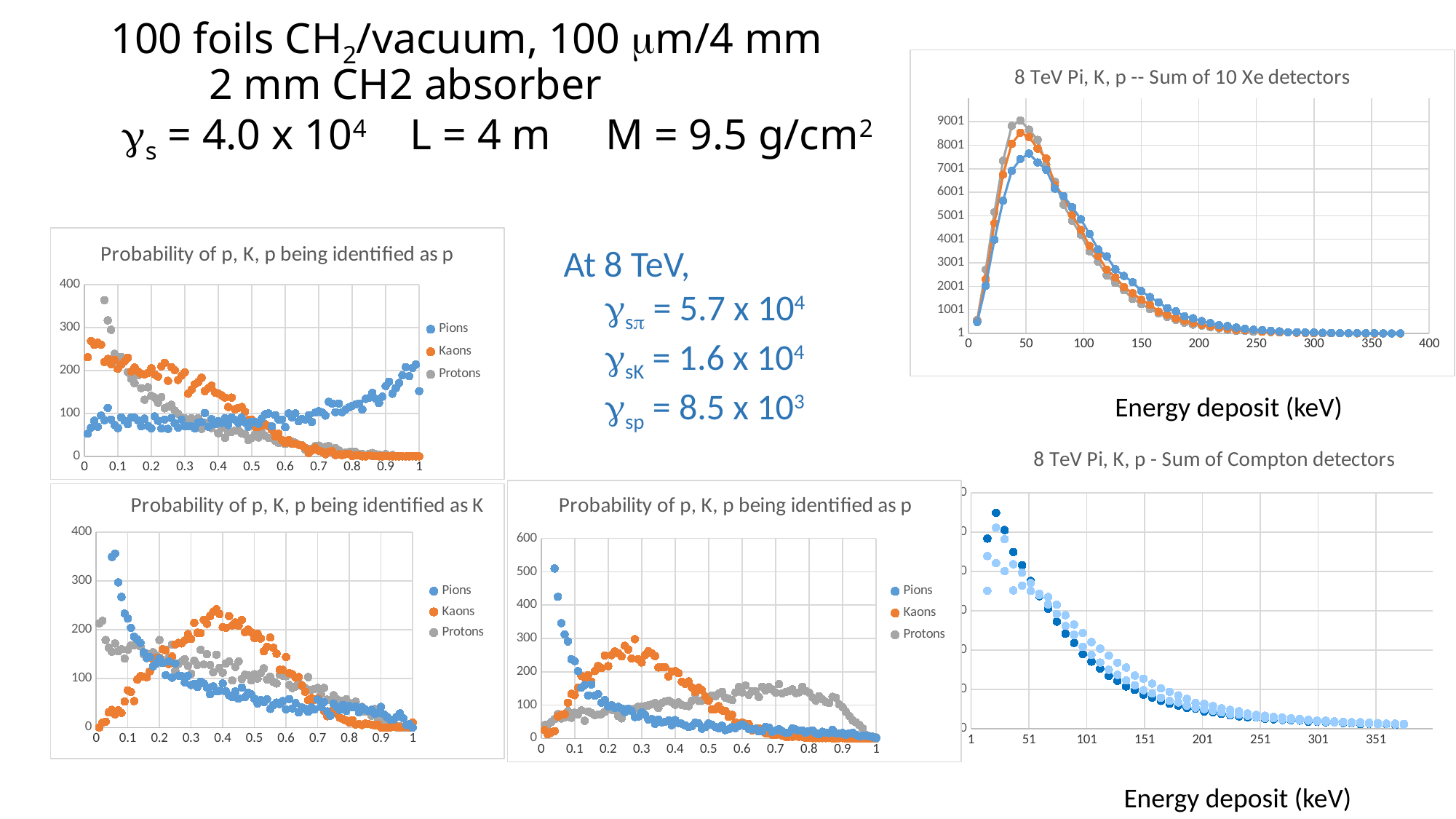
In the top-left 'Probability of p, K, p being identified as p' chart, which series reaches the highest value? Protons In the '8 TeV Pi, K, p -- Sum of 10 Xe detectors' chart, do the values rise or fall as the x axis increases beyond 100? fall What kind of chart is the '8 TeV Pi, K, p -- Sum of 10 Xe detectors' chart? scatter chart In the top-left 'Probability of p, K, p being identified as p' chart, is the highest Protons value greater or less than 300? greater What are the legend entries in the bottom-middle 'Probability of p, K, p being identified as p' chart? Pions, Kaons, Protons What is the largest x-axis tick label on the '8 TeV Pi, K, p -- Sum of 10 Xe detectors' chart? 400 In the 'Probability of p, K, p being identified as K' chart, which series reaches the highest value? Pions How many series does the legend list in the 'Probability of p, K, p being identified as K' chart? 3 In the bottom-middle 'Probability of p, K, p being identified as p' chart, is the highest Protons value greater or less than 200? less In the bottom-middle 'Probability of p, K, p being identified as p' chart, is the highest Pions value greater or less than 400? greater In the '8 TeV Pi, K, p - Sum of Compton detectors' chart, do the values rise or fall as the x axis increases from 51 to 351? fall